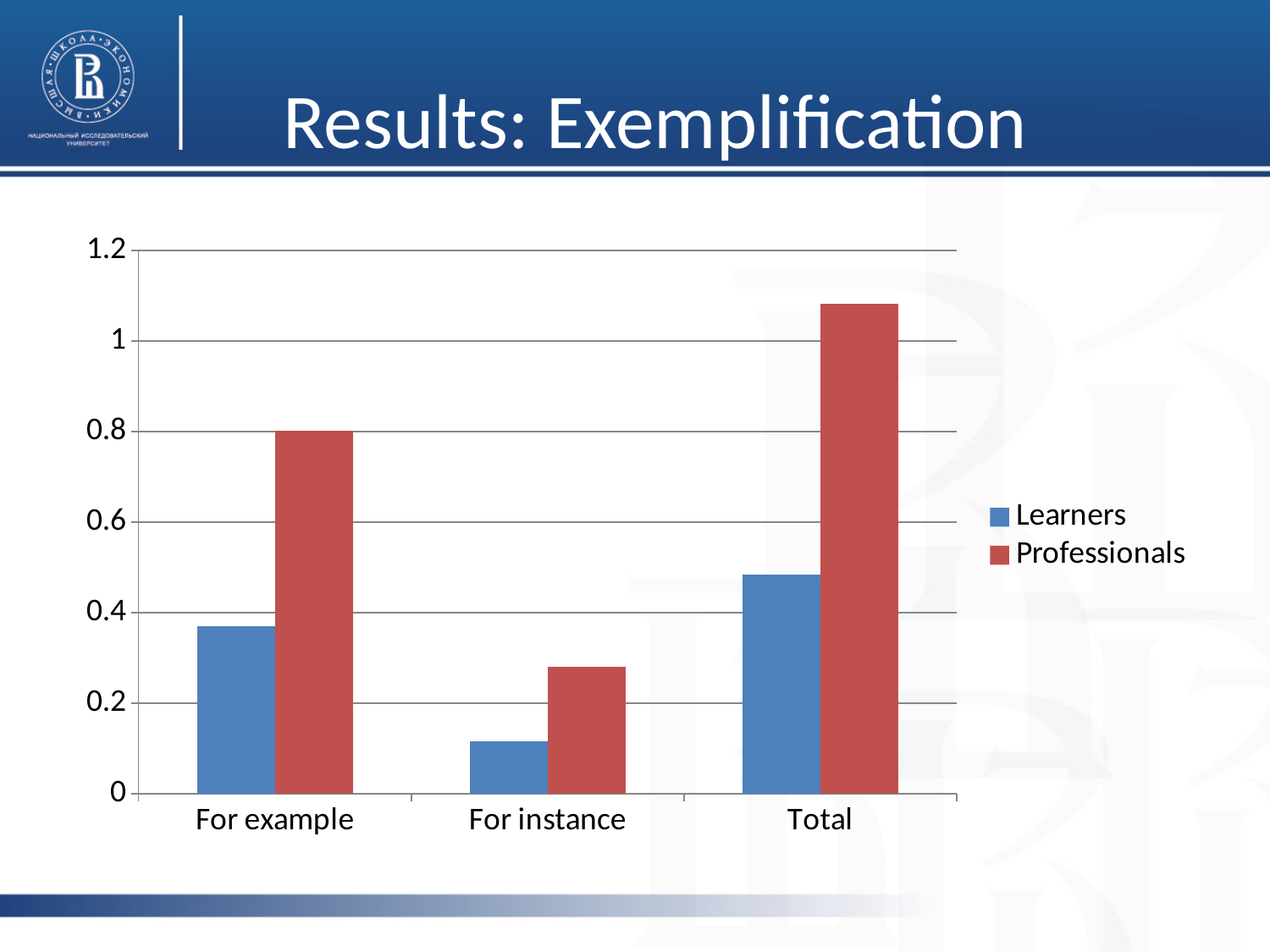
Is the Learners value for 'For example' greater or less than 0.4? less Is the Professionals value for 'For instance' greater or less than 0.4? less What kind of chart is shown on the slide? bar chart How many series does the legend list? 2 For the category 'For example', which series has the larger value, Learners or Professionals? Professionals What is the title of the slide containing the chart? Results: Exemplification Is the Learners value for 'For instance' greater or less than 0.2? less Which series is shown in red in the legend? Professionals Which bar is the shortest in the chart? Learners, For instance How many categories are shown on the x axis? 3 Which bar is the tallest in the chart? Professionals, Total